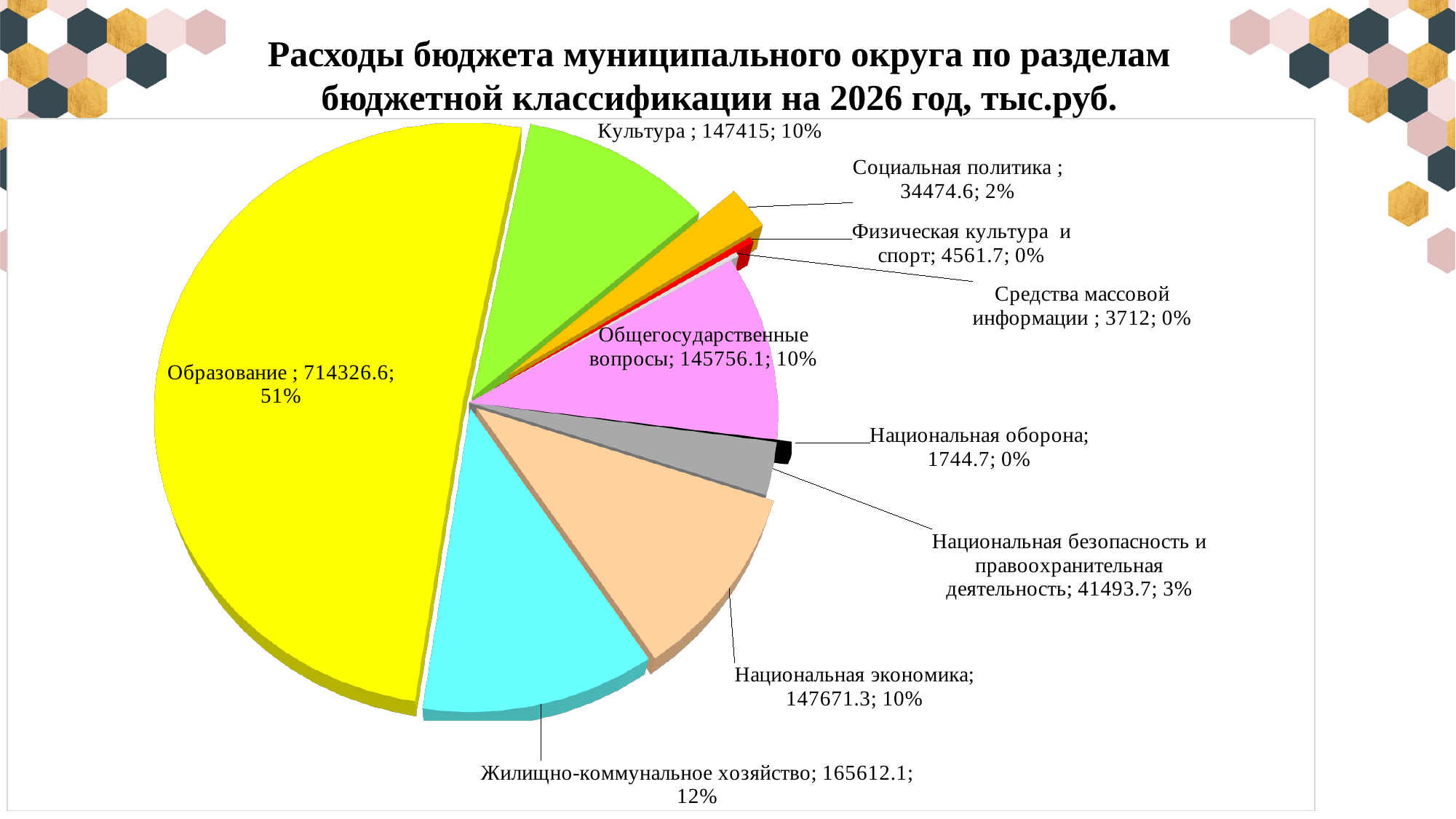
What share of the pie does Жилищно-коммунальное хозяйство represent? 12% What is the value for Жилищно-коммунальное хозяйство? 165612.1 Which is larger, the value for Социальная политика or the value for Физическая культура и спорт? Социальная политика Which category has the largest share of the pie? Образование What is the value for Средства массовой информации? 3712 What share of the pie does Образование represent? 51% What is the value for Национальная безопасность и правоохранительная деятельность? 41493.7 What kind of chart is shown on the slide? Pie chart What is the value for Образование? 714326.6 What is the difference between the values for Жилищно-коммунальное хозяйство and Национальная экономика? 17940.8 Which category has the smallest value? Национальная оборона How many categories are shown in the pie chart? 10